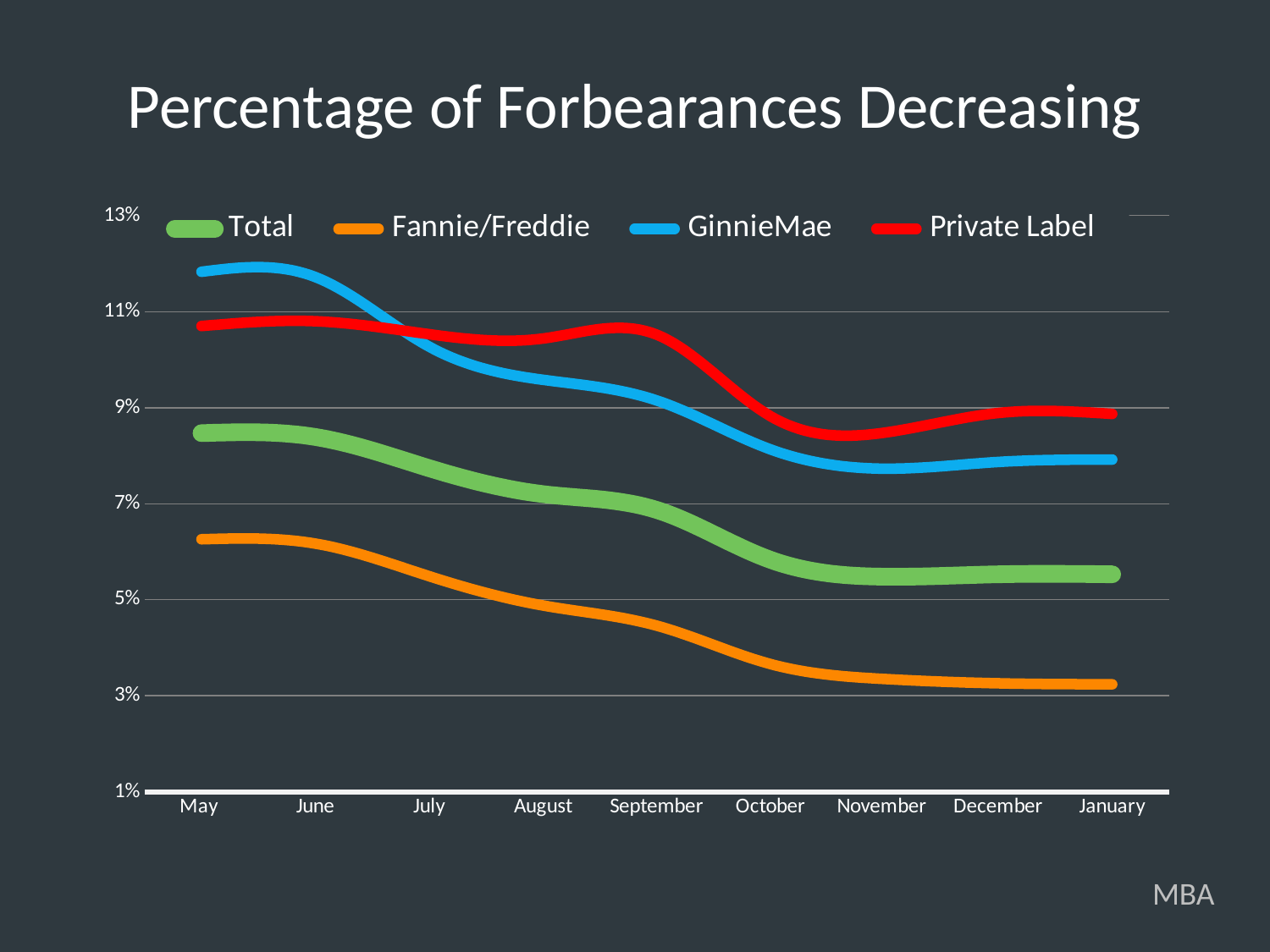
Is the value for Private Label in November greater or less than 9%? less What kind of chart is shown on the slide? line chart Is the value for Fannie/Freddie in May greater or less than 5%? greater In September, which is higher: Total or Fannie/Freddie? Total Which series has the highest value in May? GinnieMae In January, which is higher: Private Label or GinnieMae? Private Label How many months are shown along the x axis? 9 Is the value for GinnieMae in May greater or less than 11%? greater Which series has the lowest value in January? Fannie/Freddie Does the Total series rise or fall from May to January? fall What is the title of the chart? Percentage of Forbearances Decreasing How many series does the legend list? 4